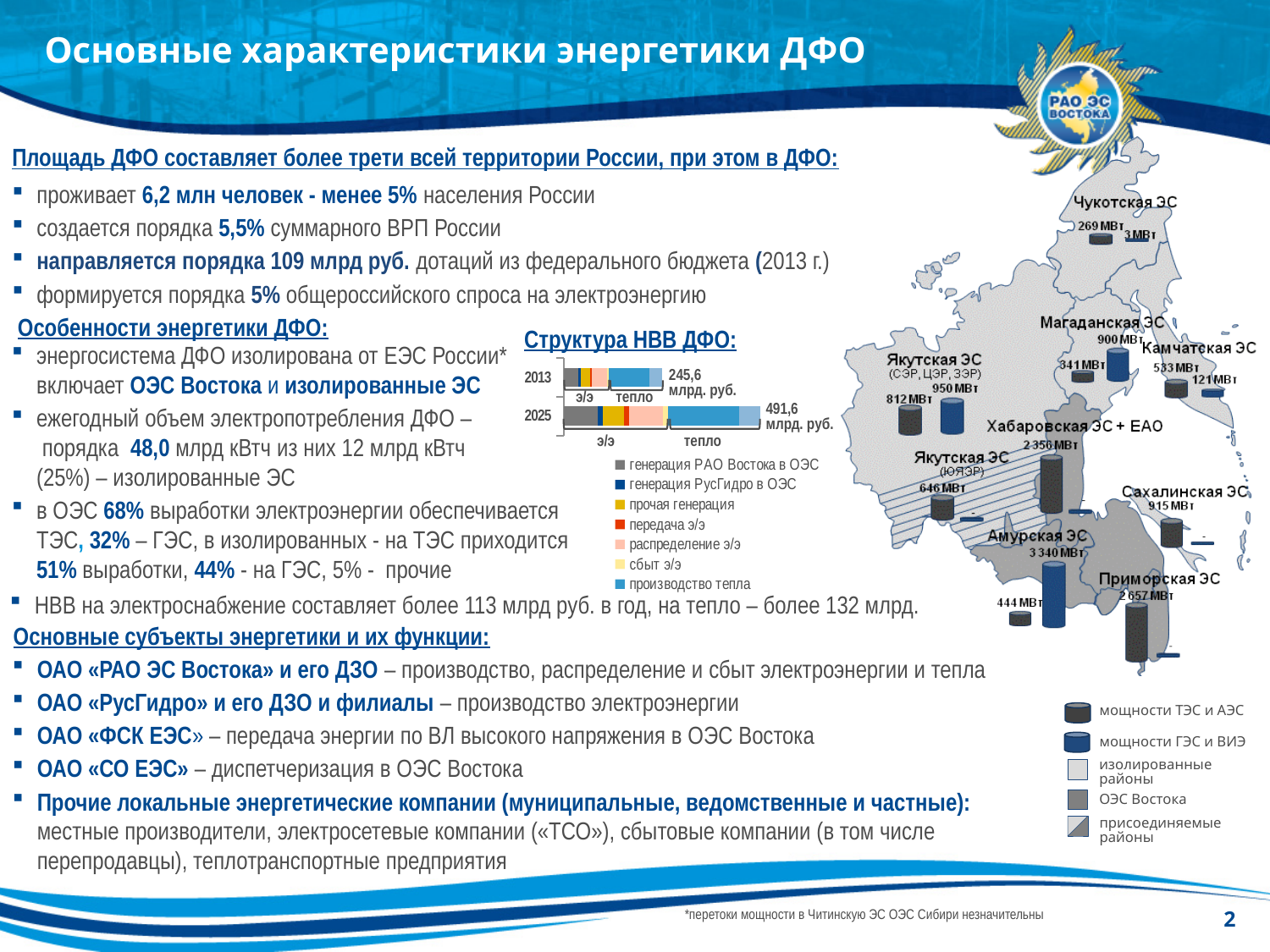
In the "Структура НВВ ДФО" chart, does the total rise or fall from 2013 to 2025? Rise In the "Структура НВВ ДФО" chart, which year has the larger total, 2013 or 2025? 2025 In the "Структура НВВ ДФО" chart, what is the total value of the 2013 bar? 245,6 млрд. руб. In the "Структура НВВ ДФО" chart, which year has the lowest total? 2013 What kind of chart is "Структура НВВ ДФО"? Stacked bar chart In the "Структура НВВ ДФО" chart, what is the difference between the 2025 total and the 2013 total? 246,0 млрд. руб. In the "Структура НВВ ДФО" chart, what is the total value of the 2025 bar? 491,6 млрд. руб. What is the title of the stacked bar chart on the slide? Структура НВВ ДФО How many series does the legend of the "Структура НВВ ДФО" chart list? 7 In the "Структура НВВ ДФО" chart, which legend entry is listed last? производство тепла In the "Структура НВВ ДФО" chart, which year has the highest total? 2025 In the "Структура НВВ ДФО" chart, how many years (bars) are shown? 2